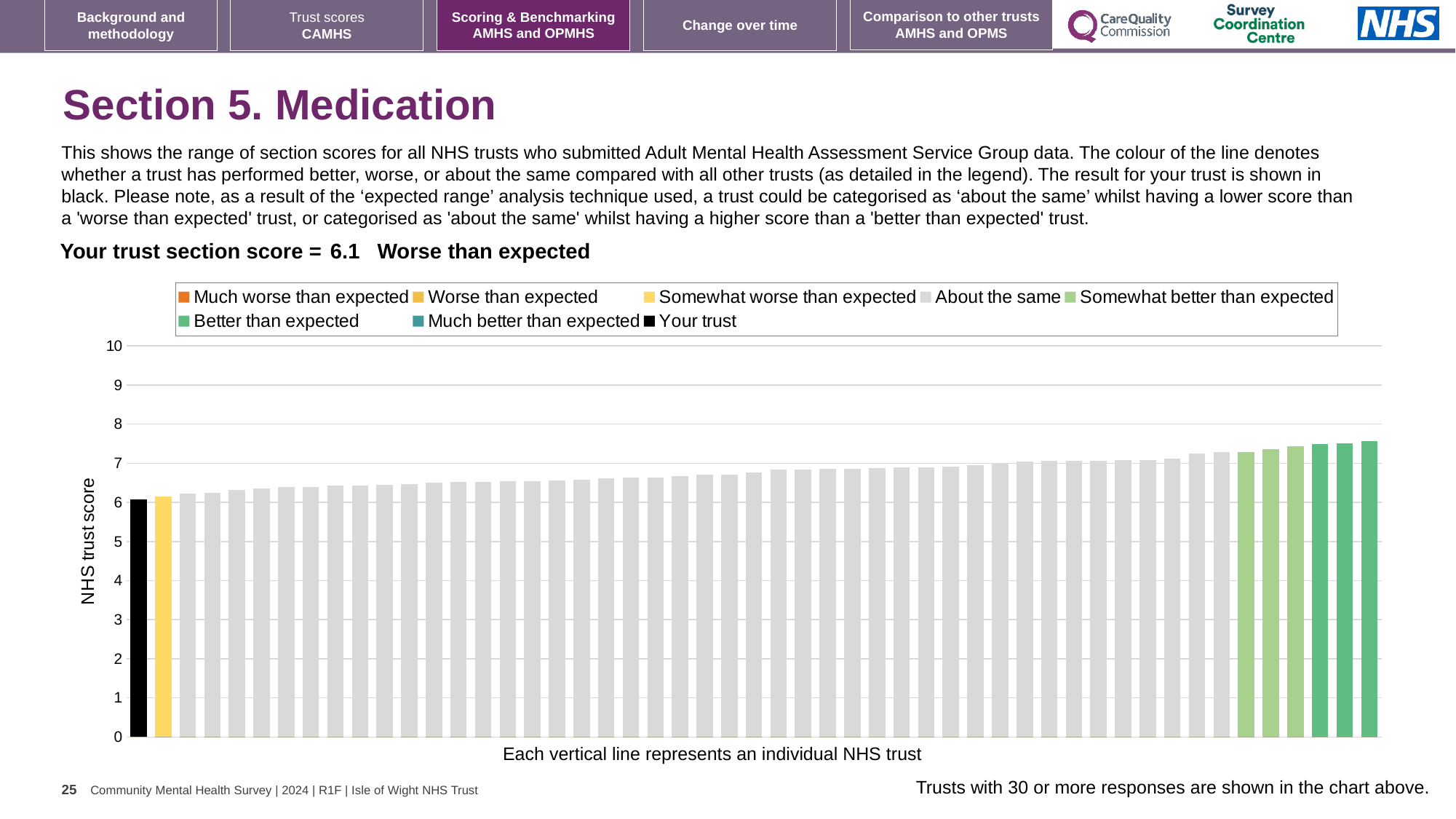
How many entries does the chart legend list? 8 Is the value of the tallest bar (rightmost) greater or less than 8? less What kind of chart is shown on the slide? bar chart Is the value of the tallest bar (rightmost) greater or less than 7? greater What is the section score for your trust shown on the slide? 6.1 Do the bar values rise or fall moving from left to right along the x axis? rise How many bars are coloured as 'Better than expected' (darker green)? 3 Is the value of the black 'Your trust' bar greater or less than 5? greater Which is larger: the black 'Your trust' bar or the rightmost bar? the rightmost bar What is the title of the vertical axis? NHS trust score